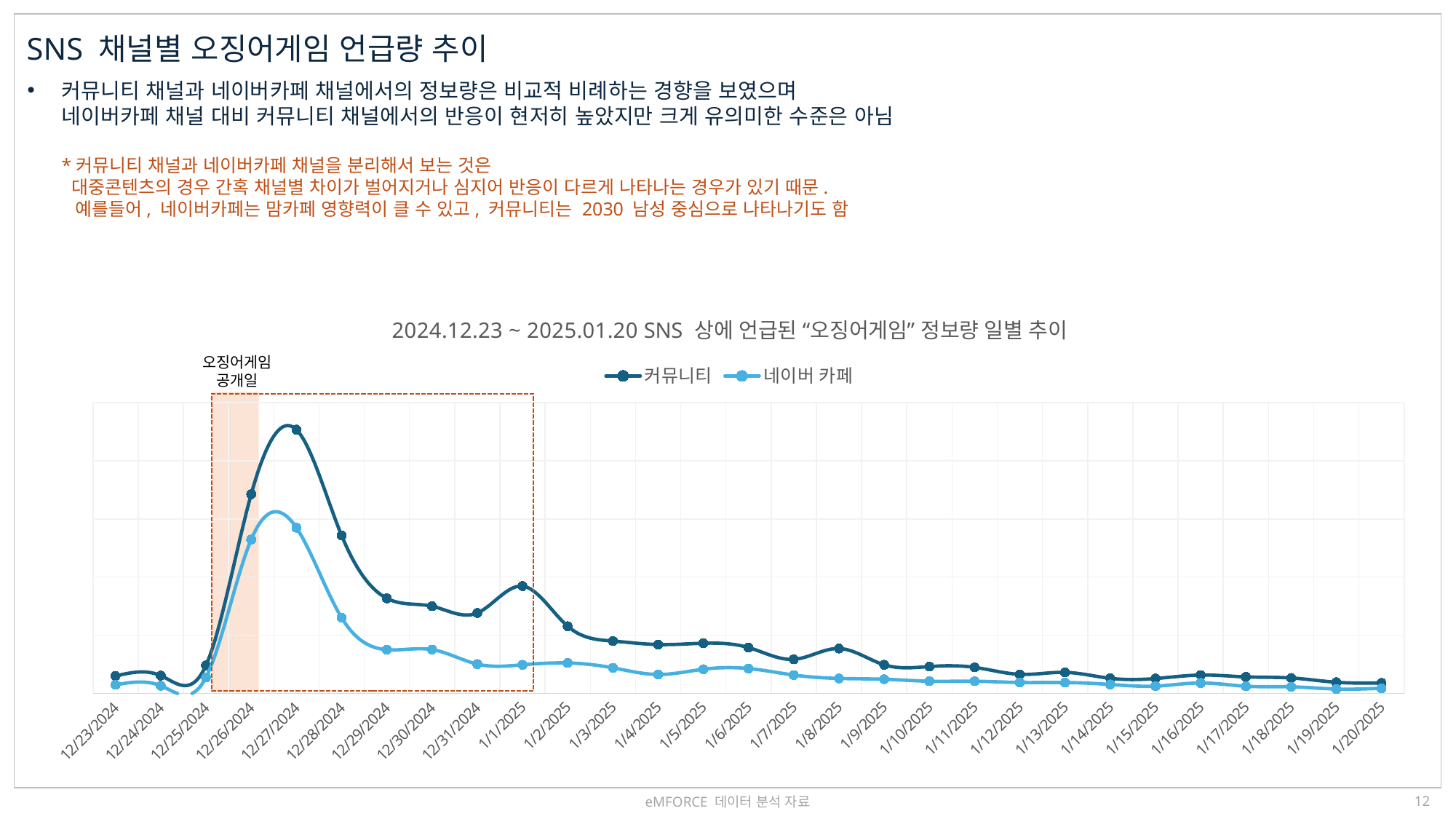
What are the two series named in the legend? 커뮤니티, 네이버 카페 On which date does the 커뮤니티 series reach its highest value? 12/27/2024 For the 커뮤니티 series, which is higher: the value on 12/28/2024 or on 1/1/2025? 12/28/2024 On 12/27/2024, which series is higher, 커뮤니티 or 네이버 카페? 커뮤니티 What kind of chart is shown on the slide? Line chart How many dates are plotted along the x axis? 29 What is the first date shown on the x axis? 12/23/2024 For the 네이버 카페 series, which is higher: the value on 12/28/2024 or on 12/29/2024? 12/28/2024 How many series does the legend list? 2 What is the title of the chart? 2024.12.23 ~ 2025.01.20 SNS 상에 언급된 “오징어게임” 정보량 일별 추이 Does the 커뮤니티 series generally rise or fall from 12/27/2024 to 1/20/2025? Fall Does the 커뮤니티 series rise or fall from 12/23/2024 to 12/27/2024? Rise